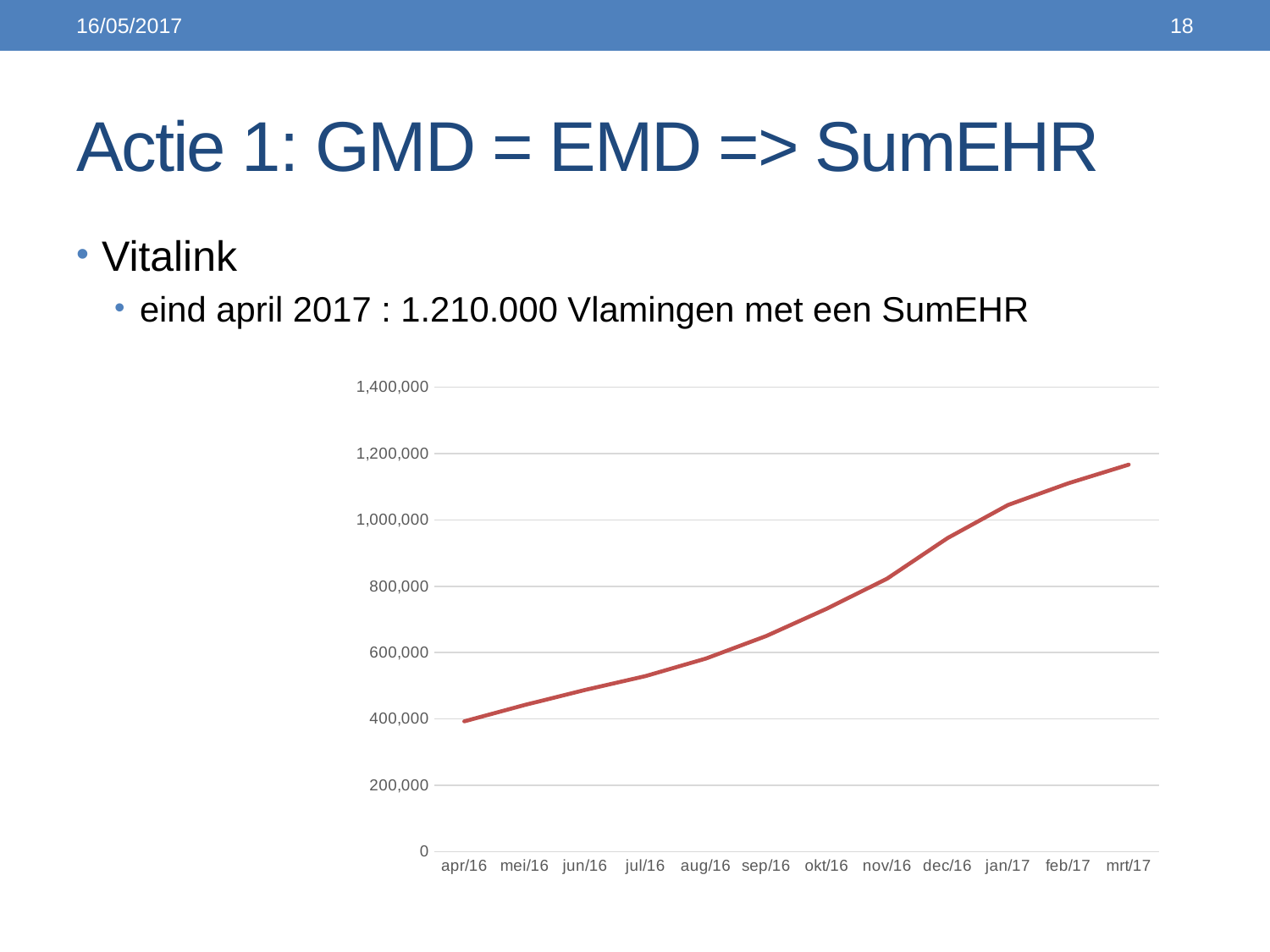
What colour is the line in the chart? red Which month has the highest value in the chart? mrt/17 Which is larger, the value for jan/17 or the value for aug/16? jan/17 Do the values in the chart rise or fall from apr/16 to mrt/17? rise Is the value for dec/16 greater or less than 1,000,000? less Is the value for sep/16 greater or less than 600,000? greater How many months are plotted along the x axis of the chart? 12 Is the value for mrt/17 greater or less than 1,000,000? greater Which month has the lowest value in the chart? apr/16 What kind of chart is shown on the slide? line chart